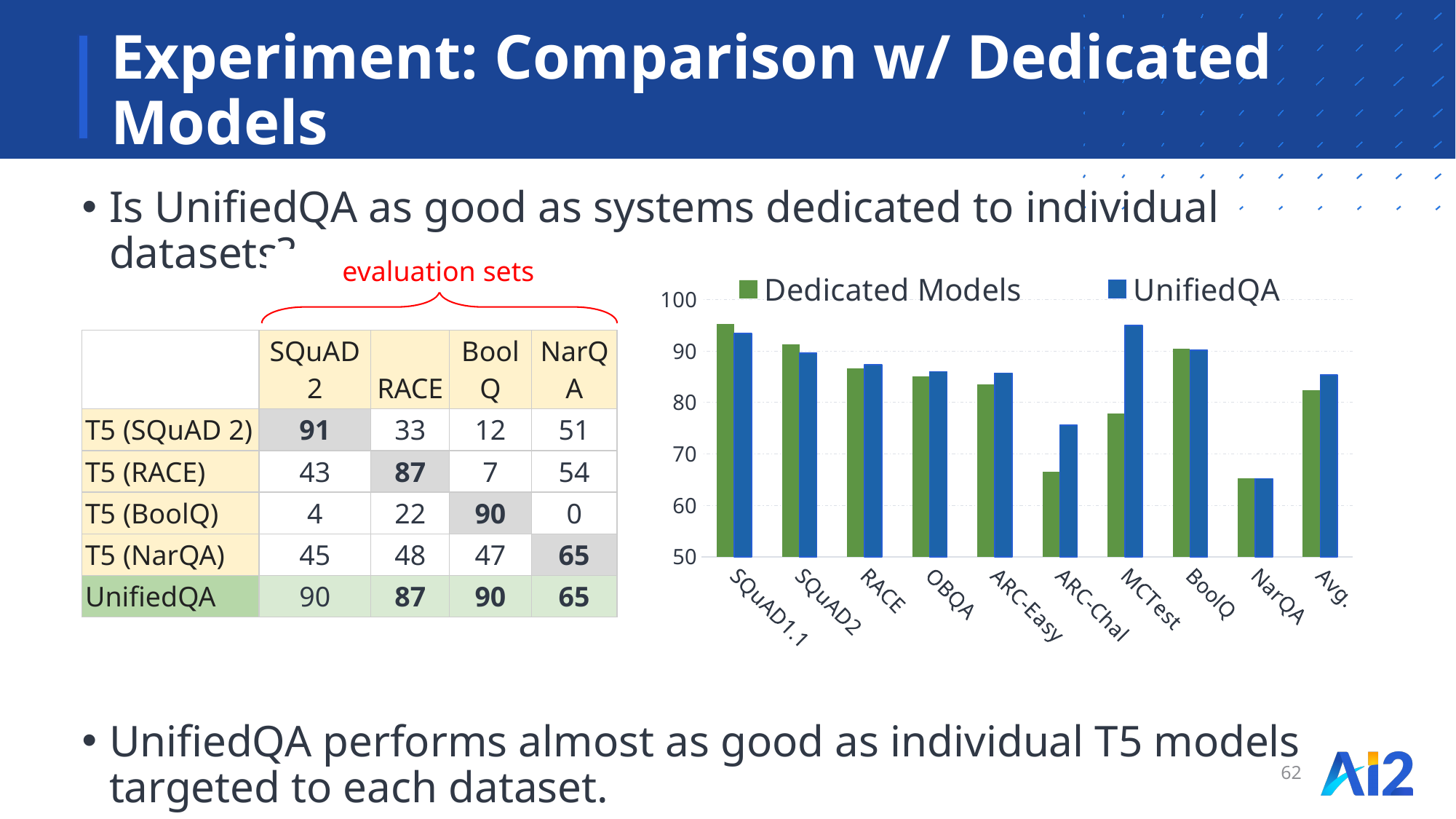
For MCTest, which is larger: the Dedicated Models value or the UnifiedQA value? UnifiedQA Which category has the lowest UnifiedQA value in the chart? NarQA Is the UnifiedQA value for Avg. greater or less than 80? greater How many series does the chart's legend list? 2 For ARC-Chal, which is larger: the Dedicated Models value or the UnifiedQA value? UnifiedQA How many categories are shown along the x axis of the chart? 10 What are the two series named in the chart's legend? Dedicated Models and UnifiedQA What kind of chart is shown on the slide? bar chart Is the Dedicated Models value for ARC-Chal greater or less than 70? less Is the Dedicated Models value for MCTest greater or less than 80? less Which series is shown in blue in the chart? UnifiedQA